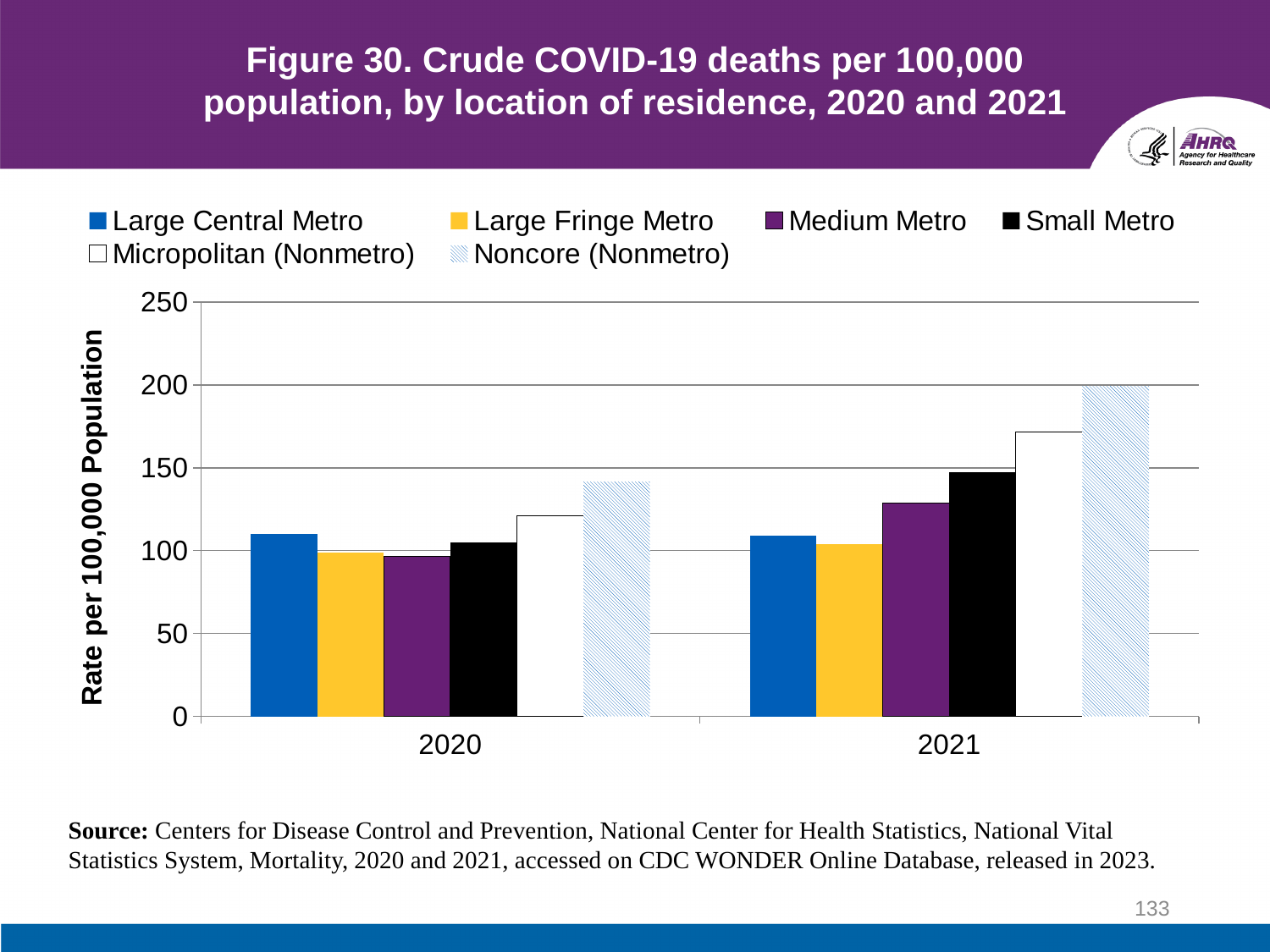
How many year categories are shown on the x axis? 2 How many series does the legend list? 6 Is the value for Micropolitan (Nonmetro) in 2021 greater or less than 150? greater Which location of residence has the highest rate in 2021? Noncore (Nonmetro) Which location of residence has the highest rate in 2020? Noncore (Nonmetro) What kind of chart is shown on the slide? bar chart Is the value for Medium Metro in 2021 greater or less than 100? greater Does the Noncore (Nonmetro) rate rise or fall from 2020 to 2021? rise What is the title of the y axis? Rate per 100,000 Population Is the value for Noncore (Nonmetro) in 2020 greater or less than 100? greater Which is larger: the Small Metro rate in 2020 or the Small Metro rate in 2021? 2021